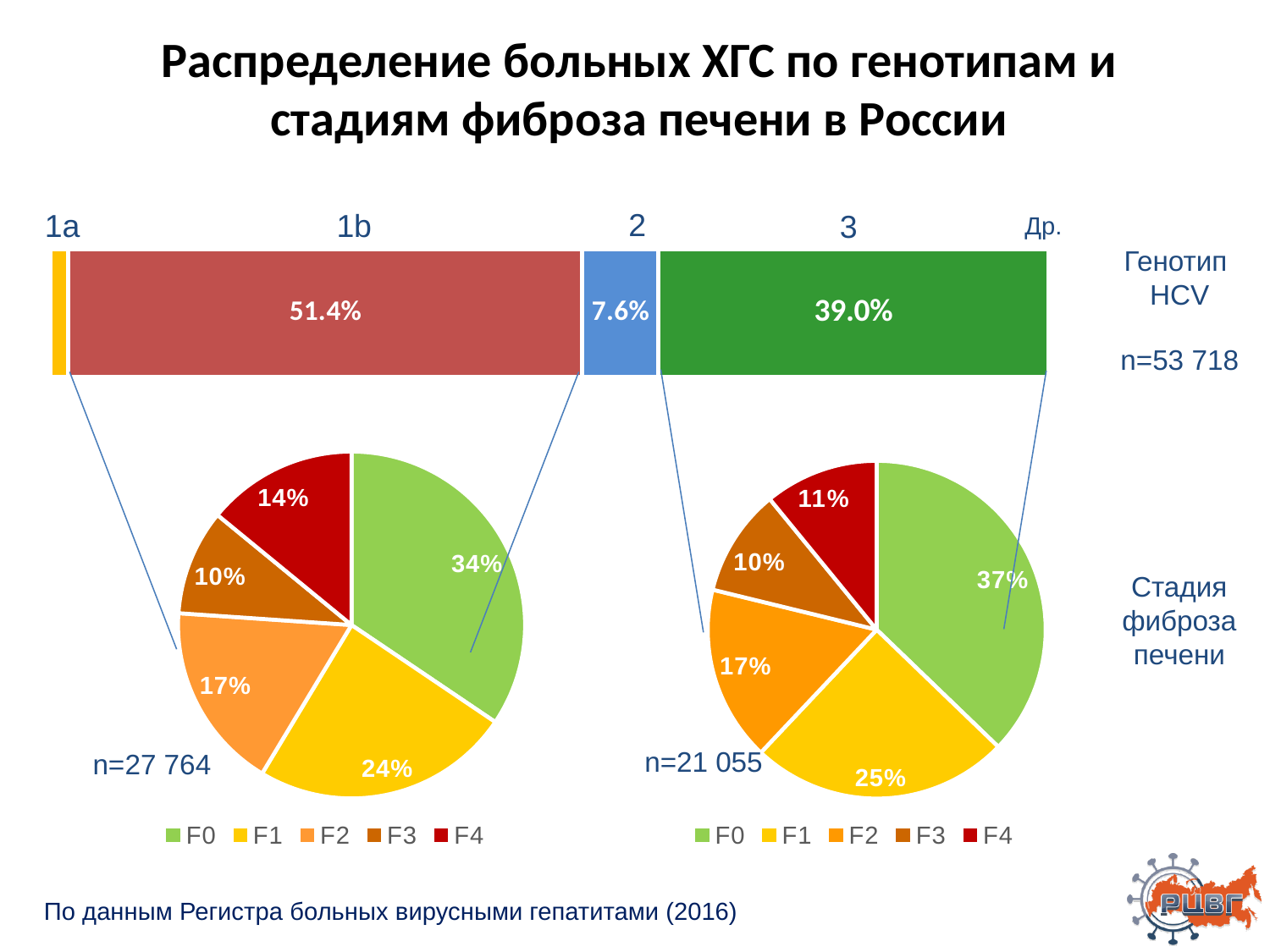
In the top bar chart of HCV genotypes, which labelled genotype has the largest share? 1b Is the F1 share larger in the left pie chart (n=27 764) or the right pie chart (n=21 055)? right pie chart (25%) In the top bar chart of HCV genotypes, what is the difference between the shares of genotype 1b and genotype 3? 12.4% How many fibrosis stages does the legend of each pie chart list? 5 In the right pie chart (n=21 055), what share is F4? 11% In the top bar chart of HCV genotypes, what share is shown for genotype 1b? 51.4% In the top bar chart of HCV genotypes, what share is shown for genotype 3? 39.0% In the top bar chart of HCV genotypes, what share is shown for genotype 2? 7.6% In the left pie chart (n=27 764), which fibrosis stage has the smallest share? F3 In the left pie chart (n=27 764), what share is F0? 34% In the right pie chart (n=21 055), which fibrosis stage has the largest share? F0 What type of chart is used to show the distribution of HCV genotypes at the top of the slide? stacked bar chart